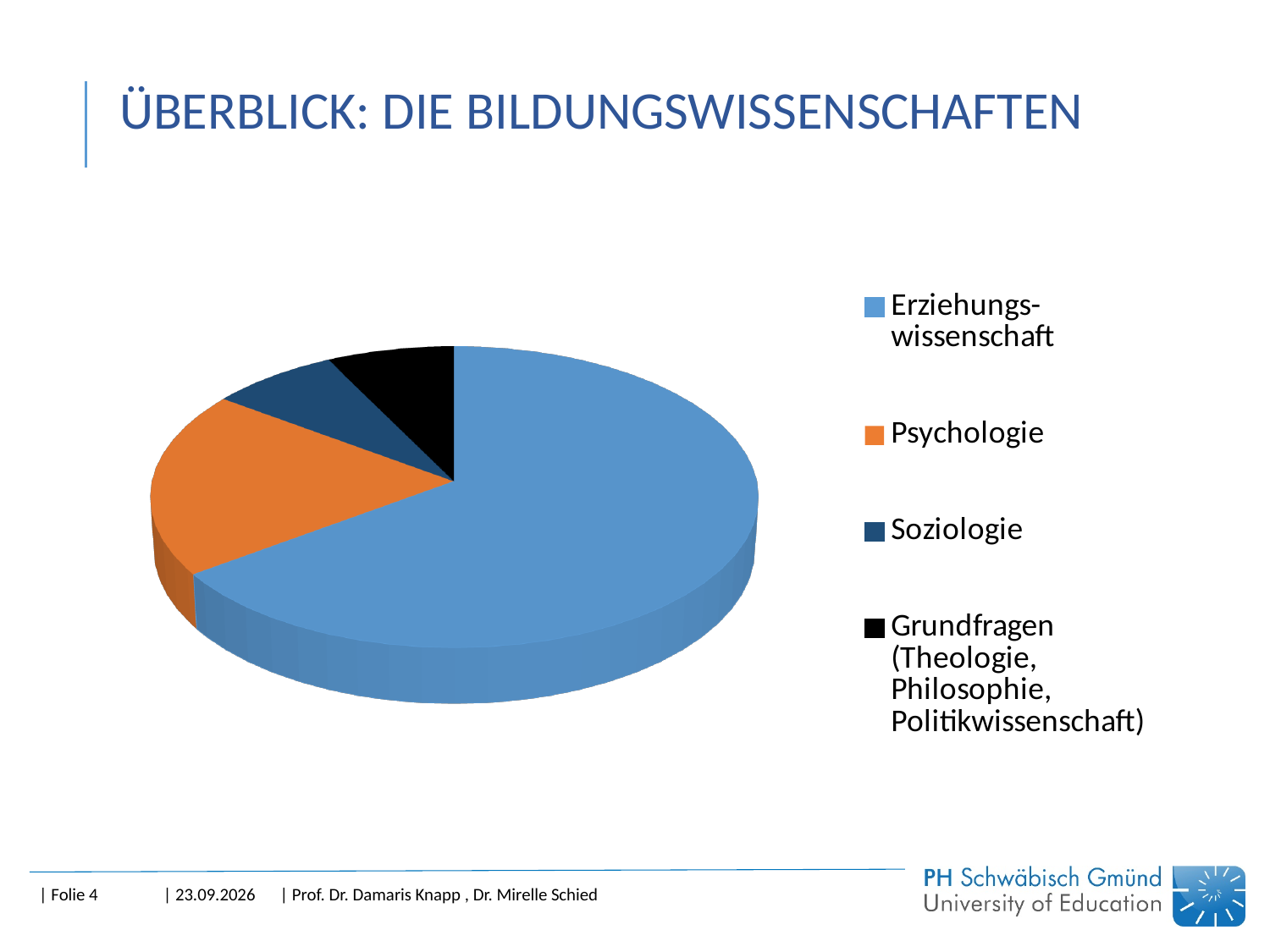
Which slice is larger, Psychologie or Soziologie? Psychologie Which slice is larger, Erziehungswissenschaft or Psychologie? Erziehungswissenschaft What colour is the Psychologie slice in the pie chart? Orange Which category is the second-largest slice of the pie chart? Psychologie What kind of chart is shown on the slide? Pie chart What is the title of the slide containing the pie chart? ÜBERBLICK: DIE BILDUNGSWISSENSCHAFTEN How many categories (slices) does the pie chart have? 4 Which category has the largest slice of the pie chart? Erziehungswissenschaft